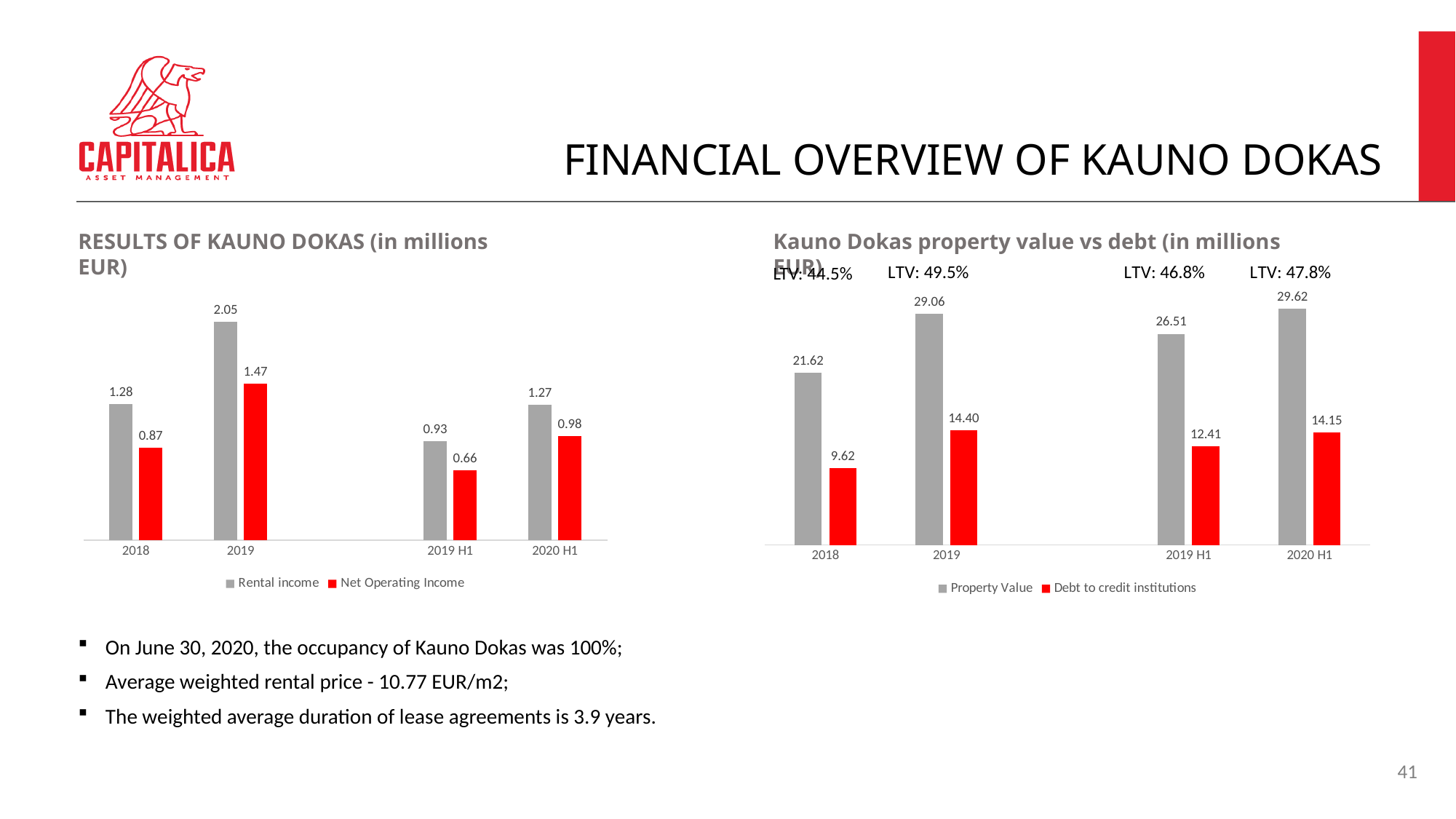
In the 'Kauno Dokas property value vs debt' chart, what is the difference between Property Value and Debt to credit institutions in 2019? 14.66 In the 'RESULTS OF KAUNO DOKAS' chart, what is the difference between Rental income and Net Operating Income in 2018? 0.41 In the 'Kauno Dokas property value vs debt' chart, what is the Property Value for 2020 H1? 29.62 In the 'Kauno Dokas property value vs debt' chart, what LTV is shown above the 2019 bars? LTV: 49.5% In the 'Kauno Dokas property value vs debt' chart, which period has the lowest Debt to credit institutions? 2018 In the 'RESULTS OF KAUNO DOKAS' chart, what is the Net Operating Income for 2019 H1? 0.66 In the 'RESULTS OF KAUNO DOKAS' chart, how many series does the legend list? 2 In the 'RESULTS OF KAUNO DOKAS' chart, how many periods are shown on the x axis? 4 In the 'RESULTS OF KAUNO DOKAS' chart, what is the Rental income for 2019? 2.05 In the 'RESULTS OF KAUNO DOKAS' chart, which period has the highest Rental income? 2019 What type of chart is the 'Kauno Dokas property value vs debt' chart? Bar chart In the 'Kauno Dokas property value vs debt' chart, what is the Debt to credit institutions for 2018? 9.62